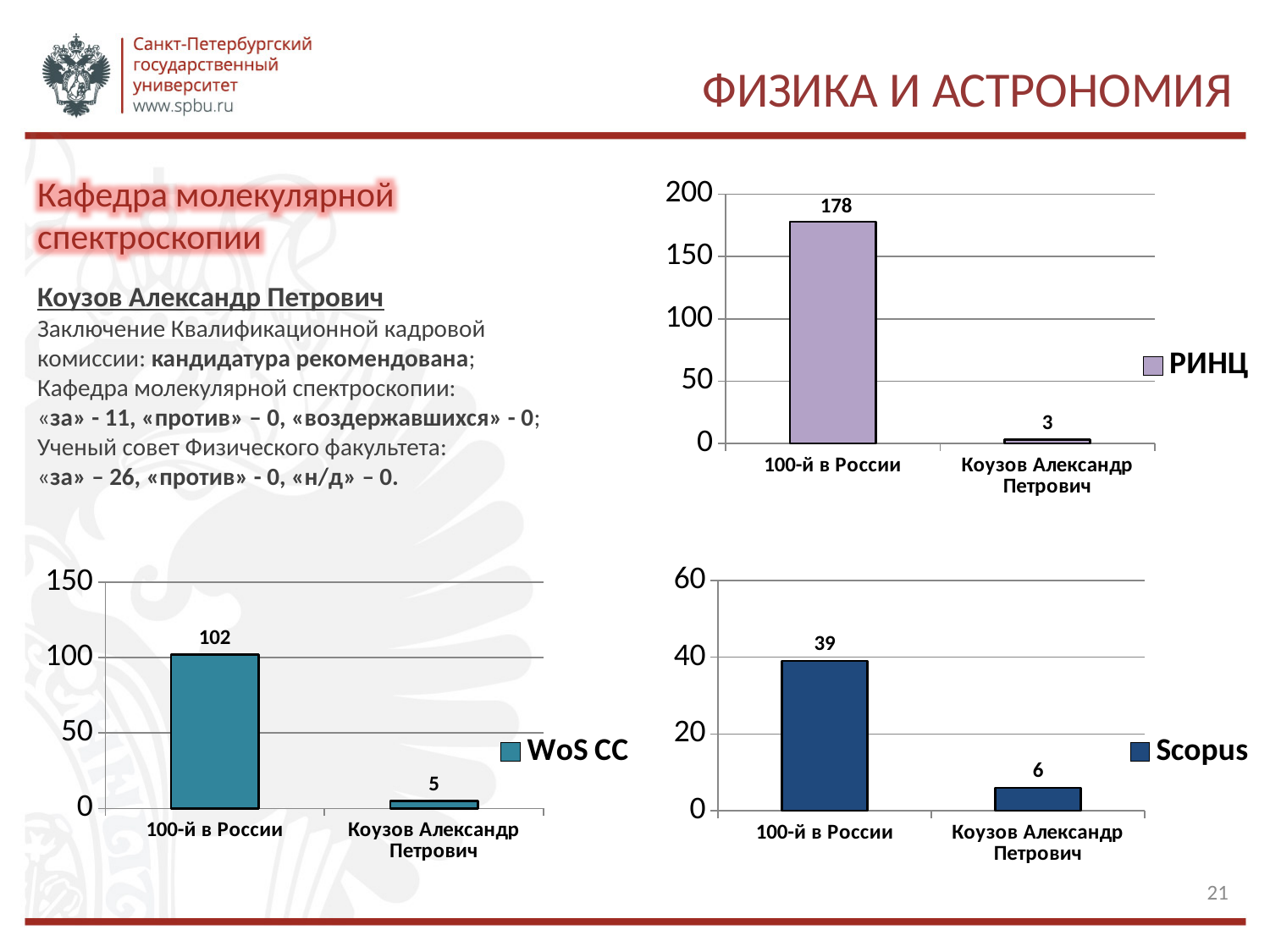
In the Scopus chart (bottom right), what is the difference between the values for 100-й в России and Коузов Александр Петрович? 33 How many charts are shown on the slide? 3 What kind of chart is the WoS CC chart (bottom left)? bar chart In the РИНЦ chart (top right), what is the value for 100-й в России? 178 In the РИНЦ chart (top right), what is the value for Коузов Александр Петрович? 3 In the РИНЦ chart (top right), what is the difference between the values for 100-й в России and Коузов Александр Петрович? 175 In the Scopus chart (bottom right), which category has the lowest value? Коузов Александр Петрович In the WoS CC chart (bottom left), which category has the highest value? 100-й в России In the WoS CC chart (bottom left), what is the value for 100-й в России? 102 In the WoS CC chart (bottom left), what is the value for Коузов Александр Петрович? 5 In the Scopus chart (bottom right), what is the value for 100-й в России? 39 In the Scopus chart (bottom right), what is the value for Коузов Александр Петрович? 6